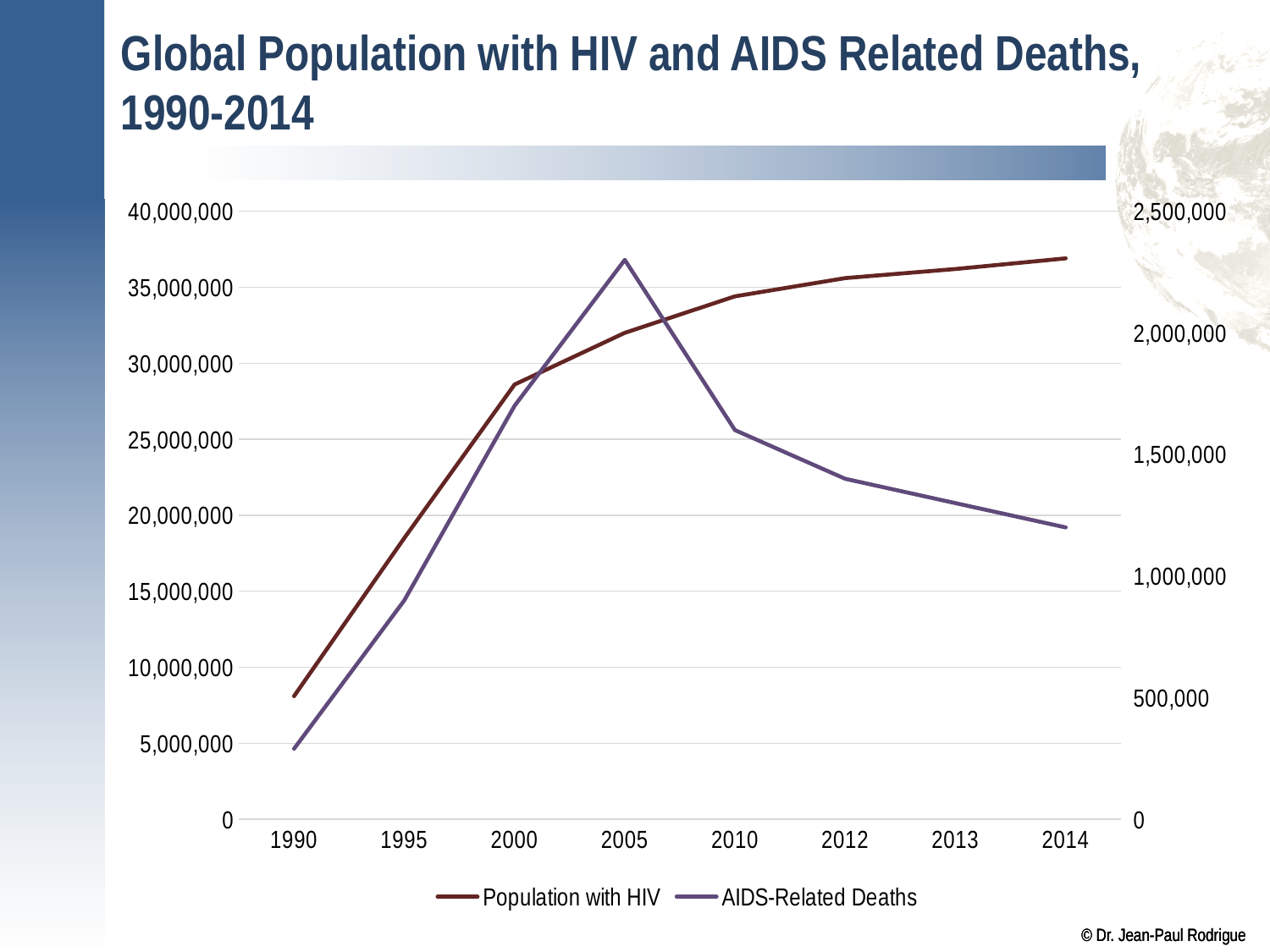
Is the value for AIDS-Related Deaths in 2005 greater or less than 2,000,000? greater Do AIDS-Related Deaths rise or fall between 2005 and 2014? fall How many series does the legend list? 2 Is the Population with HIV in 2014 greater or less than 35,000,000? greater Is the Population with HIV in 1990 greater or less than 10,000,000? less In which year are AIDS-Related Deaths highest? 2005 In which year are AIDS-Related Deaths lowest? 1990 In which year is the Population with HIV highest? 2014 Which year has more AIDS-Related Deaths, 2005 or 2014? 2005 What kind of chart is shown on the slide? line chart How many years are marked along the x axis? 8